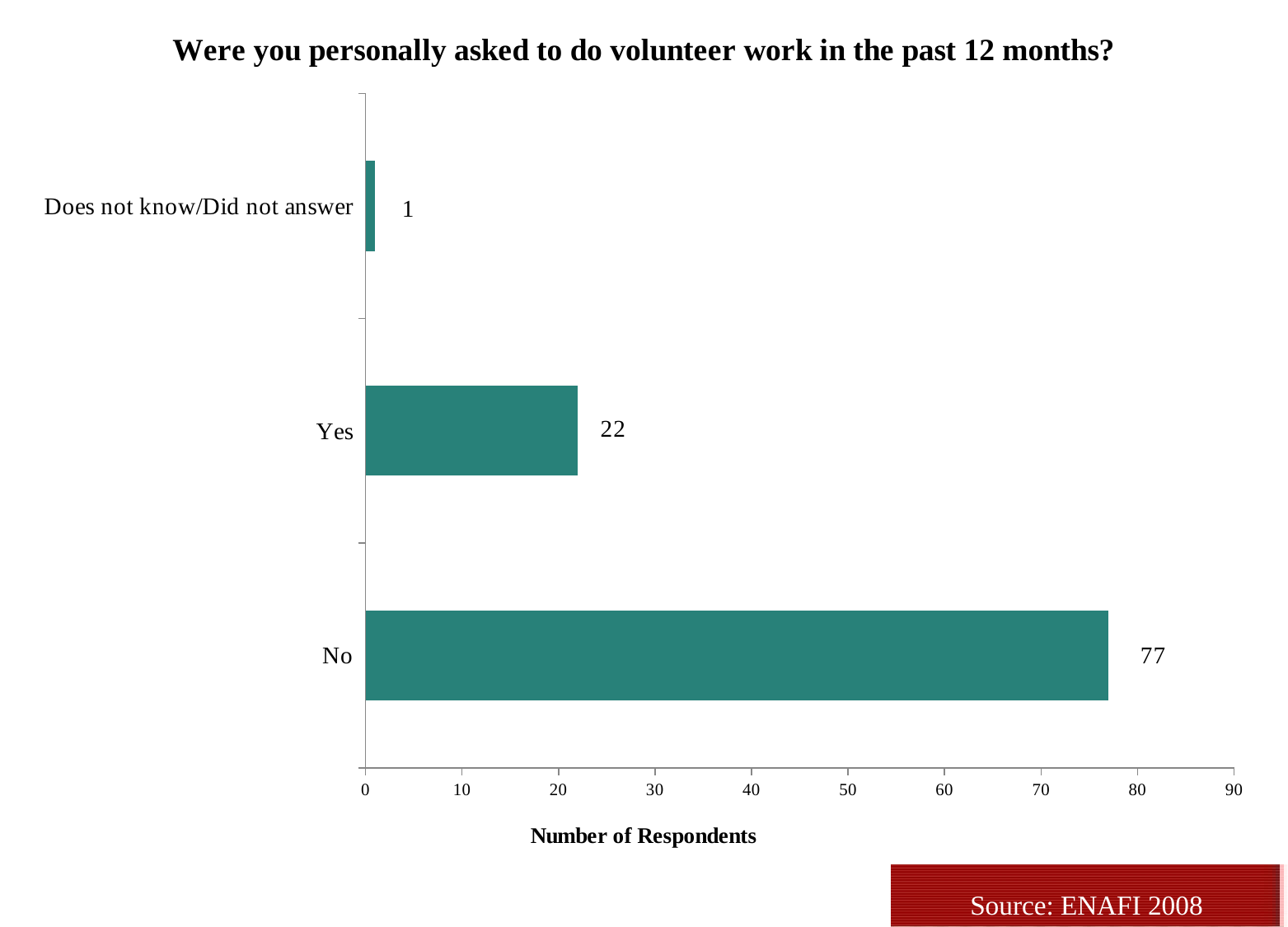
Which has more respondents, "Yes" or "Does not know/Did not answer"? Yes What is the difference in number of respondents between "No" and "Yes"? 55 What is the label of the horizontal axis? Number of Respondents Which response category has the highest number of respondents? No What kind of chart is shown on the slide? Bar chart What is the title of the chart? Were you personally asked to do volunteer work in the past 12 months? What is the number of respondents who answered "Yes"? 22 Is the value for "No" greater or less than 70? greater How many response categories are shown in the chart? 3 Which response category has the lowest number of respondents? Does not know/Did not answer What is the number of respondents who answered "No"? 77 What is the number of respondents for "Does not know/Did not answer"? 1